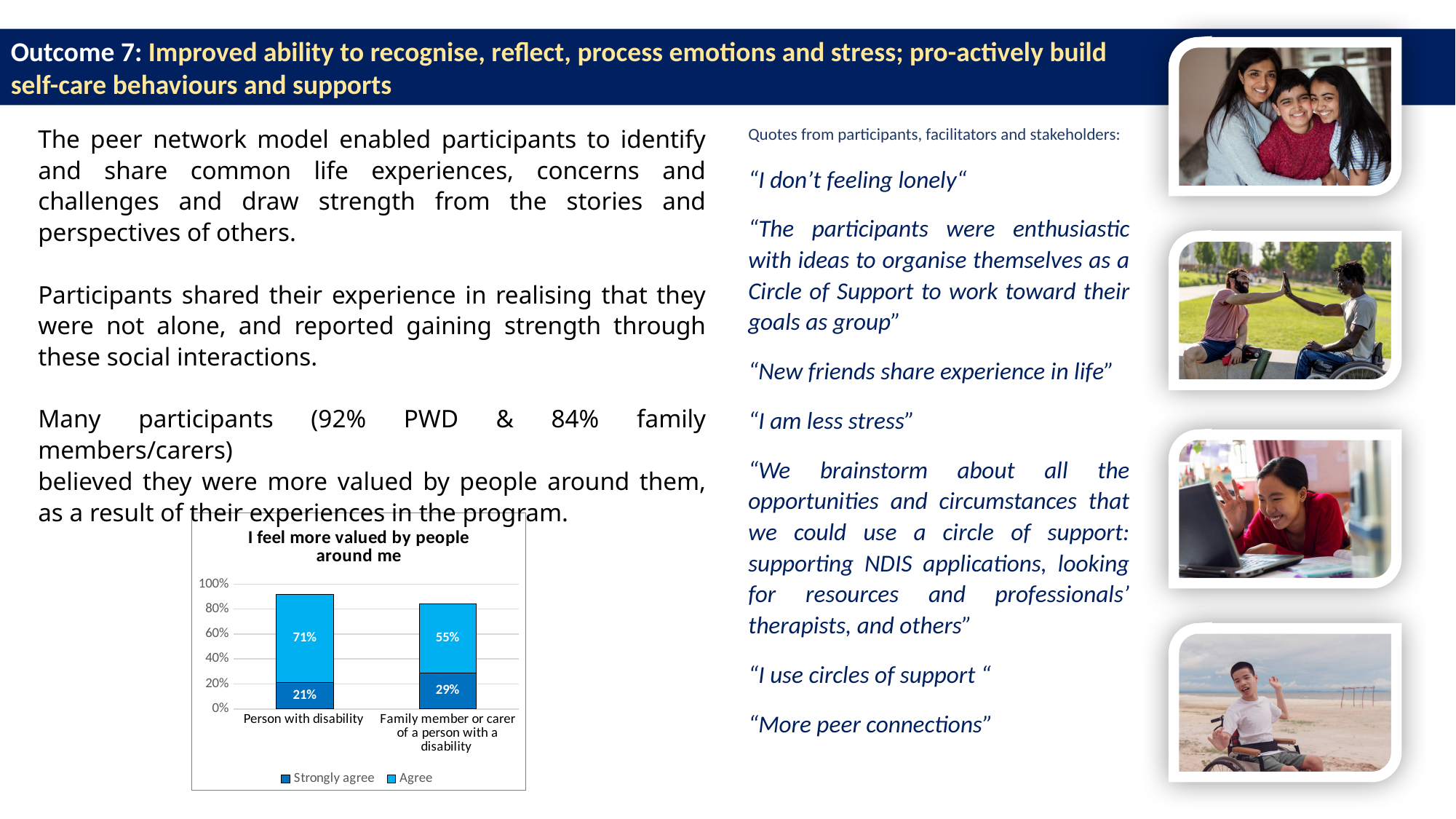
What is the 'Strongly agree' value for 'Person with disability'? 21% Which category has the higher 'Strongly agree' value? Family member or carer of a person with a disability How many series does the chart legend list? 2 What kind of chart is shown on the slide? Stacked bar chart What is the 'Agree' value for 'Person with disability'? 71% What is the 'Agree' value for 'Family member or carer of a person with a disability'? 55% What is the total of the stacked bar for 'Person with disability'? 92% What is the title of the chart? I feel more valued by people around me What is the 'Strongly agree' value for 'Family member or carer of a person with a disability'? 29% What is the total of the stacked bar for 'Family member or carer of a person with a disability'? 84% What is the difference between the 'Agree' values for 'Person with disability' and 'Family member or carer of a person with a disability'? 16% How many categories are shown on the x axis of the chart? 2